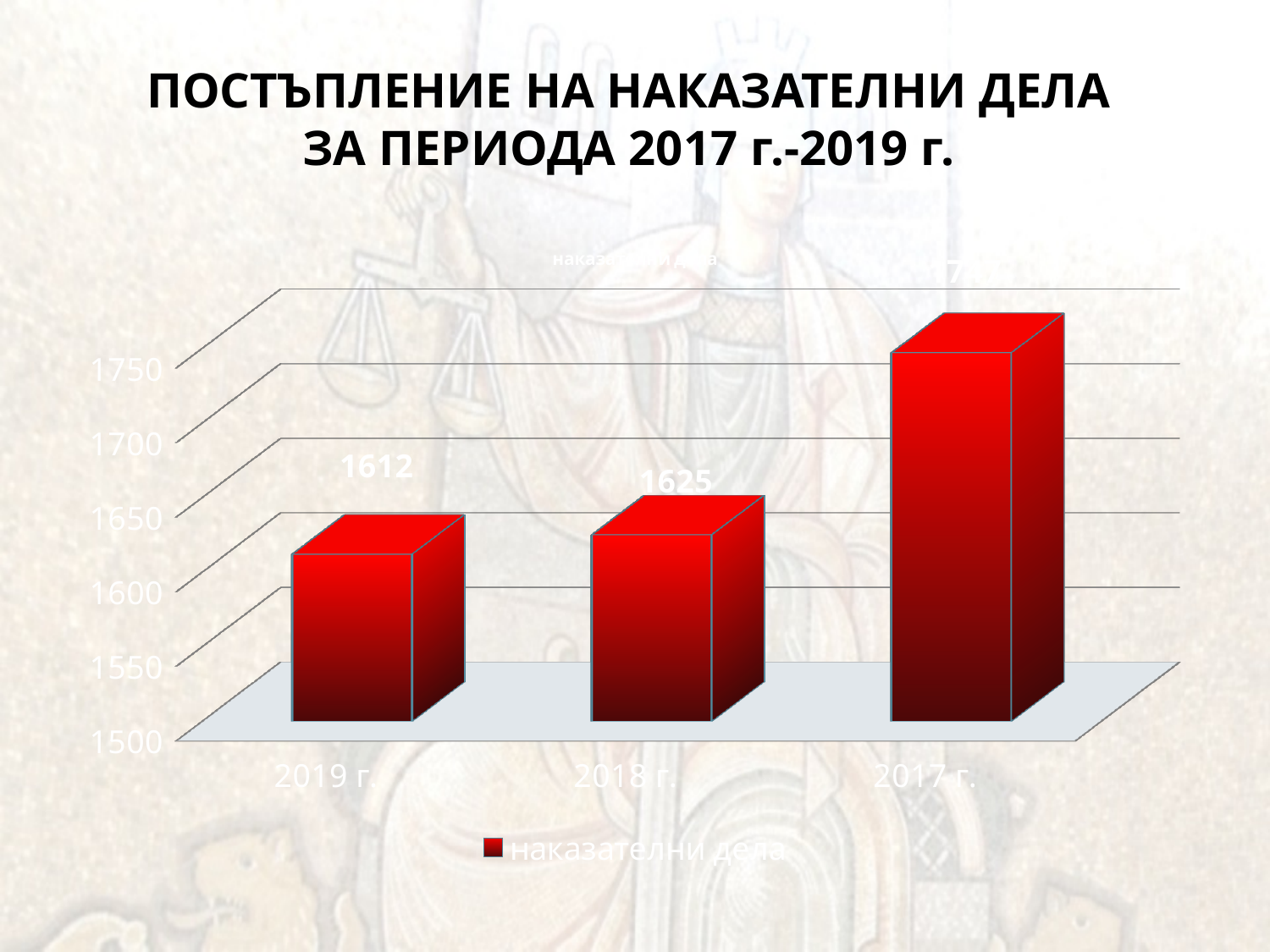
What kind of chart is shown on the slide? bar chart Do the values rise or fall moving left to right along the x axis? rise Which year has the highest value? 2017 г. How many series does the legend list? 1 What is the value for 2018 г.? 1625 Which year has the lowest value? 2019 г. How many years are shown on the x axis? 3 Which is larger, the value for 2018 г. or the value for 2019 г.? 2018 г. Is the value for 2017 г. greater or less than 1700? greater What is the difference between the values for 2018 г. and 2019 г.? 13 What is the value for 2019 г.? 1612 What is the legend entry of the chart? наказателни дела